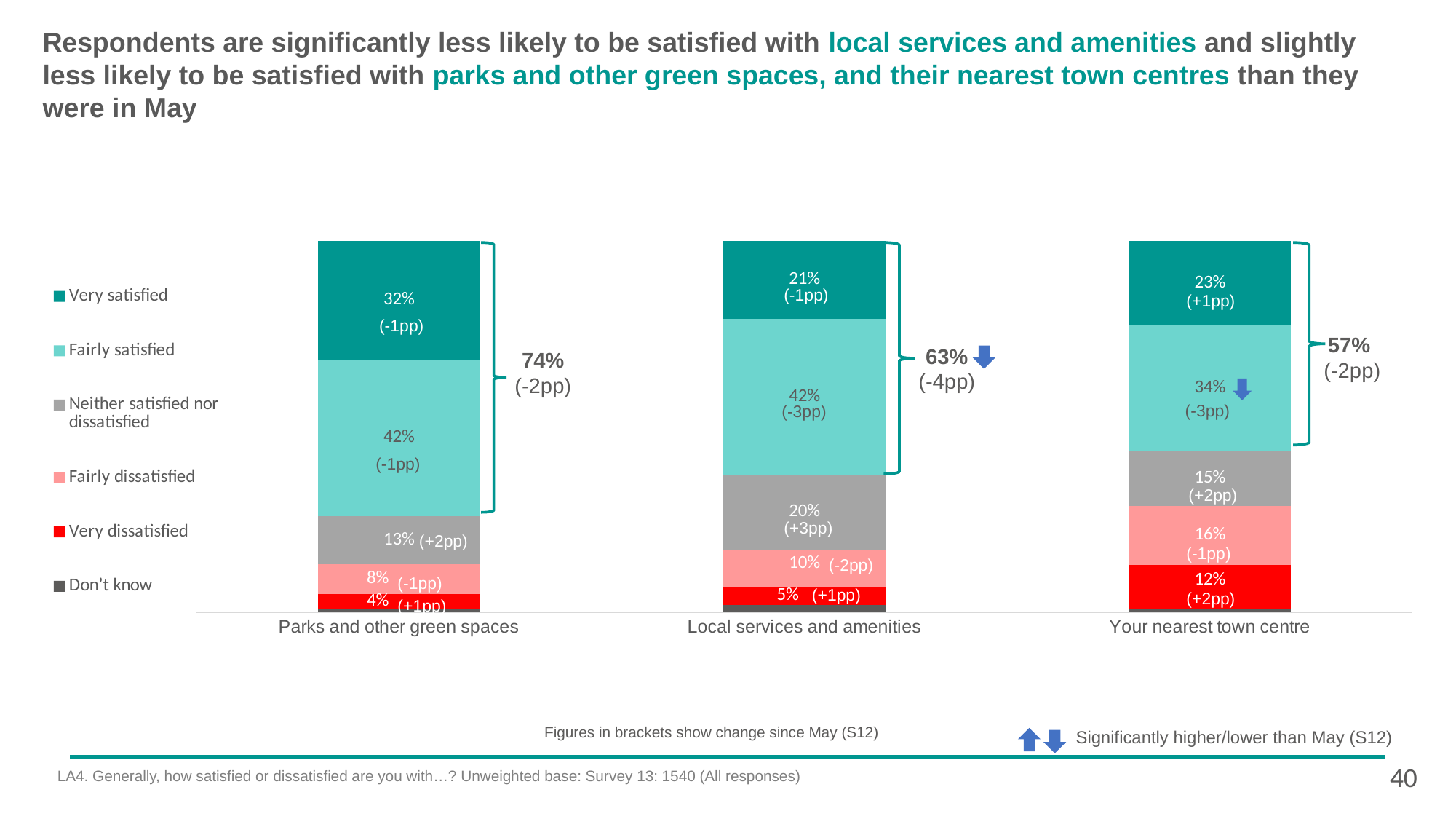
Which has a larger neither satisfied nor dissatisfied share: parks and other green spaces or local services and amenities? Local services and amenities Which category has the lowest very satisfied percentage? Local services and amenities What percentage of respondents are very dissatisfied with their nearest town centre? 12% How many categories are shown on the x axis of the chart? 3 How many series does the legend list? 6 What percentage of respondents are very satisfied with parks and other green spaces? 32% What kind of chart is shown on the slide? Stacked bar chart What percentage of respondents are fairly dissatisfied with their nearest town centre? 16% What is the combined satisfied percentage shown for local services and amenities? 63% Which category has the highest combined satisfied percentage? Parks and other green spaces What percentage of respondents are fairly satisfied with local services and amenities? 42% What is the difference in percentage points between the very satisfied share for parks and other green spaces and for your nearest town centre? 9pp